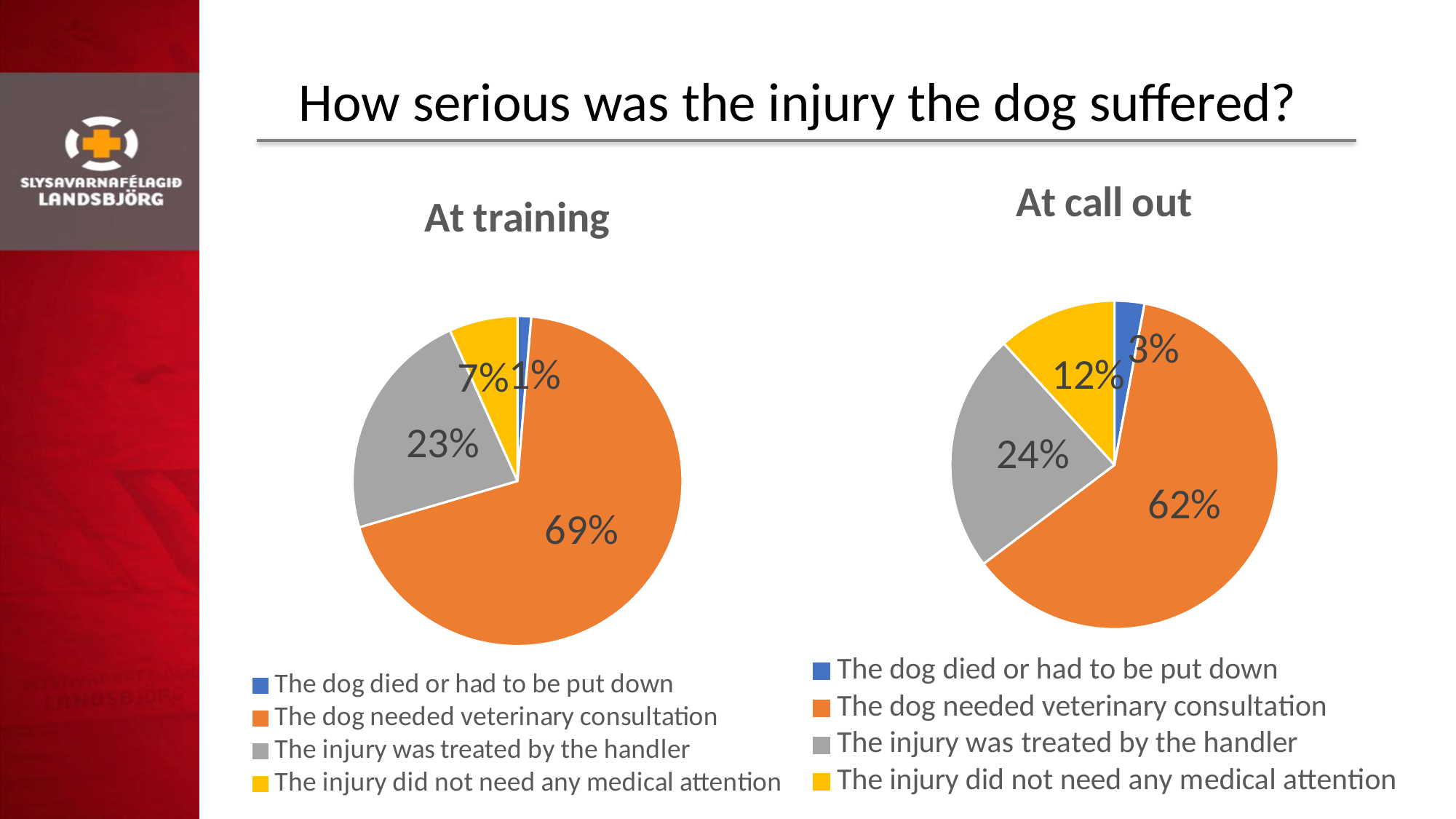
In the 'At training' pie chart, what share of injuries needed veterinary consultation? 69% In the 'At training' pie chart, which category has the largest share? The dog needed veterinary consultation What is the difference between the 'At training' share for injuries treated by the handler and the 'At call out' share for the same category? 1% In the 'At call out' pie chart, what share of injuries were treated by the handler? 24% In the 'At training' pie chart, which colour represents 'The injury was treated by the handler'? Grey In the 'At training' pie chart, what share of injuries did not need any medical attention? 7% What type of chart is used for 'At call out'? Pie chart In the 'At call out' pie chart, which category has the smallest share? The dog died or had to be put down In the 'At call out' pie chart, what is the difference between the veterinary consultation share and the handler-treated share? 38% How many slices does the 'At training' pie chart have? 4 Which is larger: the share of injuries not needing medical attention at training or at call out? At call out In the 'At call out' pie chart, what percentage of dogs died or had to be put down? 3%